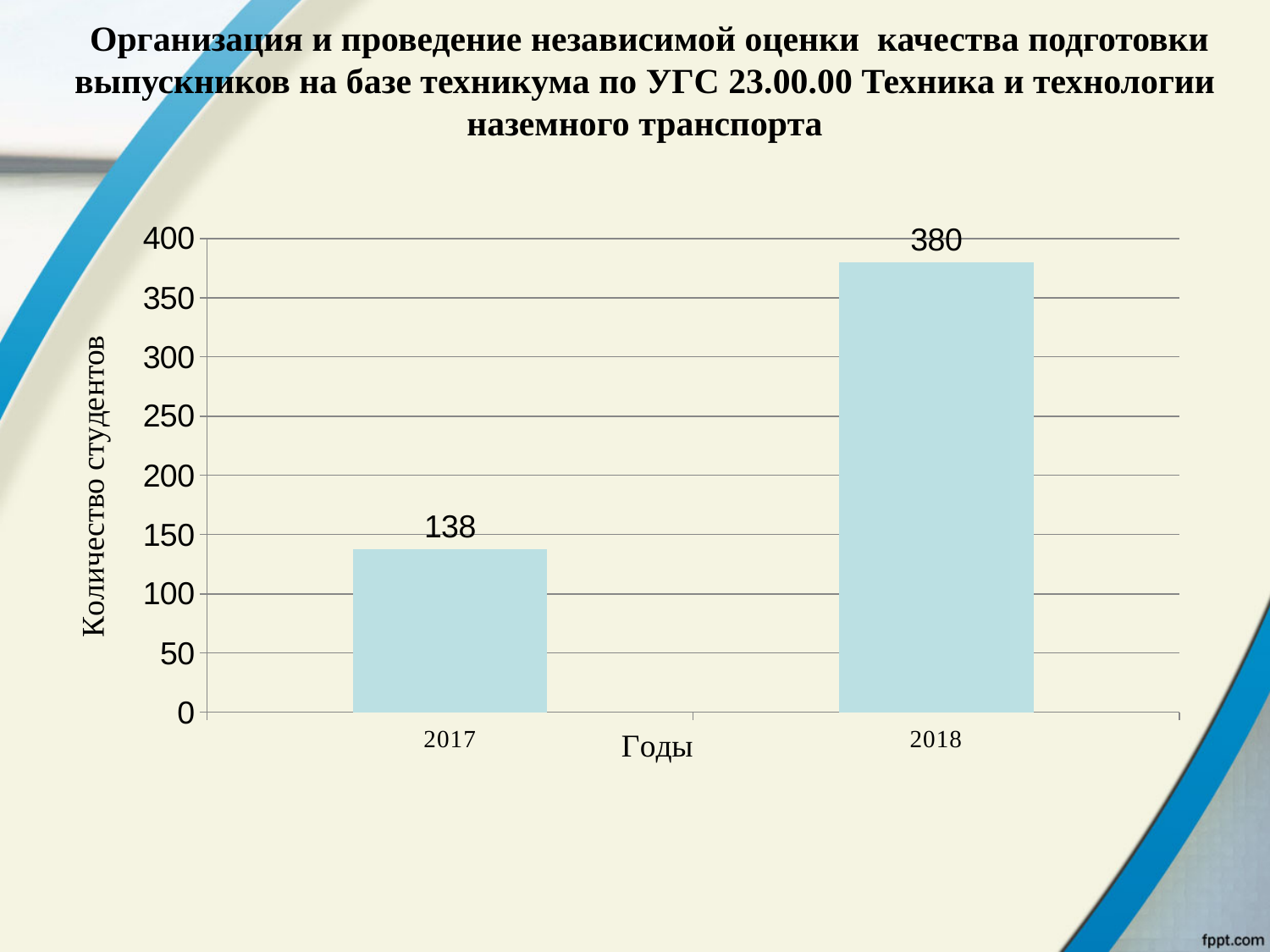
What is the value for 2018? 380 Is the value for 2017 greater or less than 150? less Which is larger, the value for 2017 or the value for 2018? 2018 What is the difference between the values for 2018 and 2017? 242 Is the value for 2018 greater or less than 350? greater Do the values rise or fall from 2017 to 2018? rise Which year has the highest value? 2018 Which year has the lowest value? 2017 What kind of chart is shown on the slide? bar chart How many years are shown on the x axis? 2 What is the label of the vertical axis? Количество студентов What is the value for 2017? 138